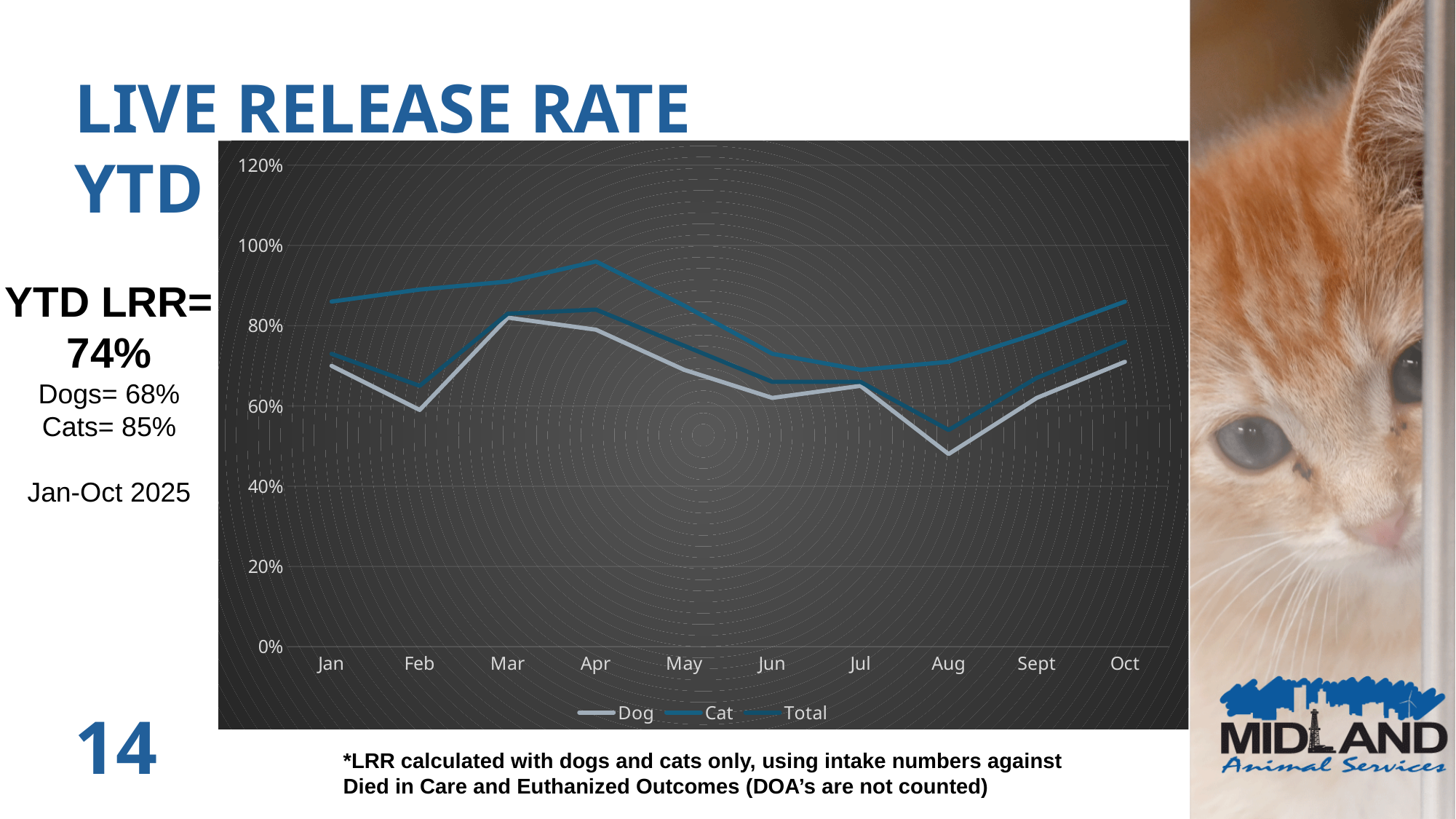
In which month does the Cat series reach its highest value? Apr Is the Cat value for Apr greater or less than 80%? greater In which month does the Dog series reach its lowest value? Aug In which month does the Total series reach its lowest value? Aug What kind of chart is shown on the slide? line chart Is the Dog value for Aug greater or less than 60%? less Is the Total value for Aug greater or less than 60%? less In Apr, which series has the higher value, Cat or Dog? Cat Does the Dog series rise or fall from Aug to Oct? rise How many series does the chart legend list? 3 Which series are listed in the chart legend? Dog, Cat, Total How many months are plotted along the x axis? 10